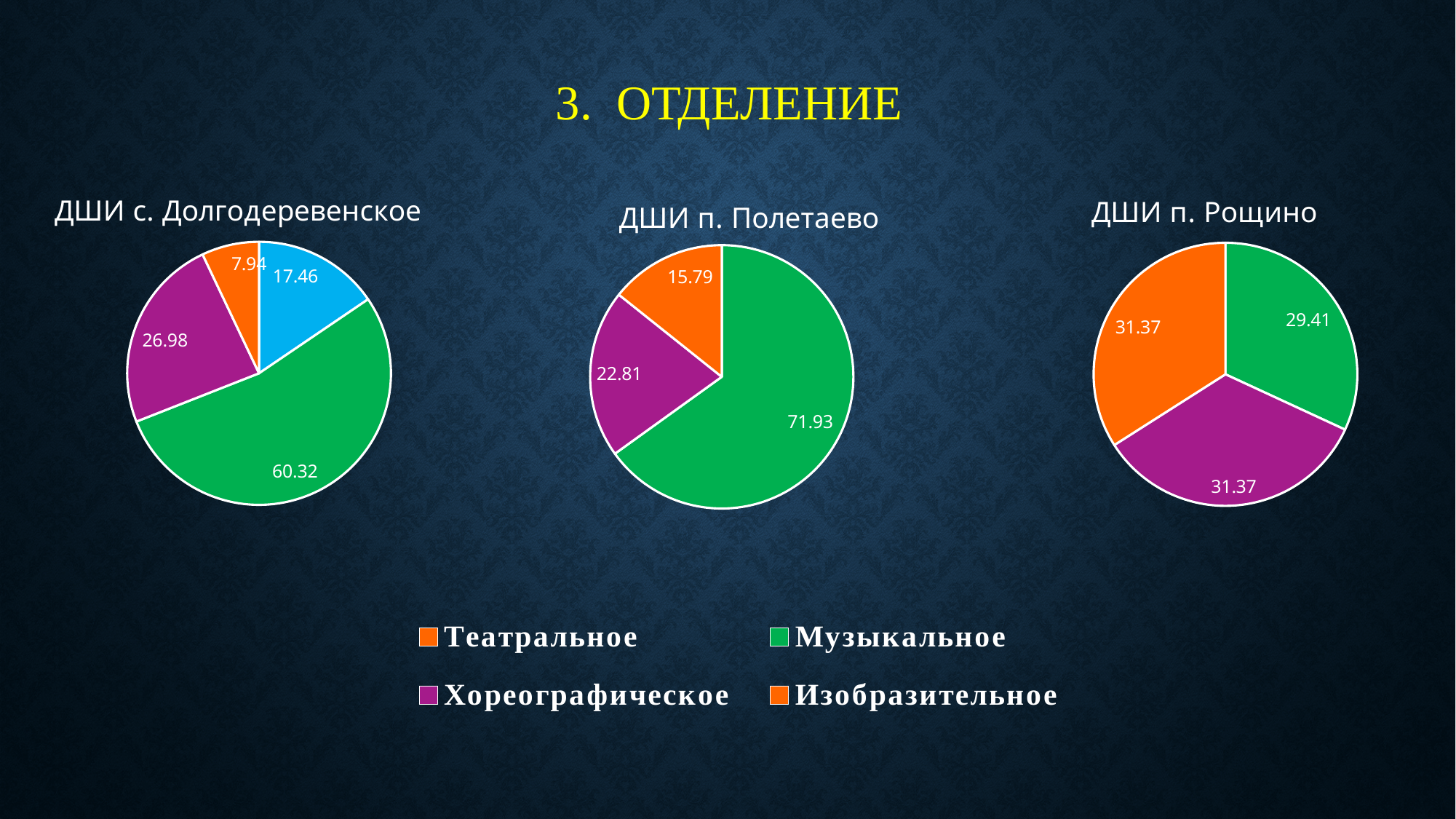
In the ДШИ п. Полетаево chart, which category has the largest slice? Музыкальное In the ДШИ п. Полетаево chart, what is the value of the Хореографическое slice? 22.81 In the ДШИ с. Долгодеревенское chart, what is the difference between the Музыкальное and Хореографическое values? 33.34 How many slices does the ДШИ п. Рощино chart have? 3 How many entries does the shared legend list? 4 In the ДШИ с. Долгодеревенское chart, which is larger: Музыкальное or Хореографическое? Музыкальное What type of chart is used for ДШИ п. Полетаево? Pie chart In the ДШИ с. Долгодеревенское chart, what is the value of the Музыкальное slice? 60.32 In the ДШИ п. Полетаево chart, what is the difference between the Музыкальное and Хореографическое values? 49.12 In the ДШИ п. Рощино chart, what is the value of the Музыкальное slice? 29.41 In the ДШИ п. Рощино chart, what is the value of the Хореографическое slice? 31.37 In the ДШИ с. Долгодеревенское chart, what is the value of the smallest slice? 7.94